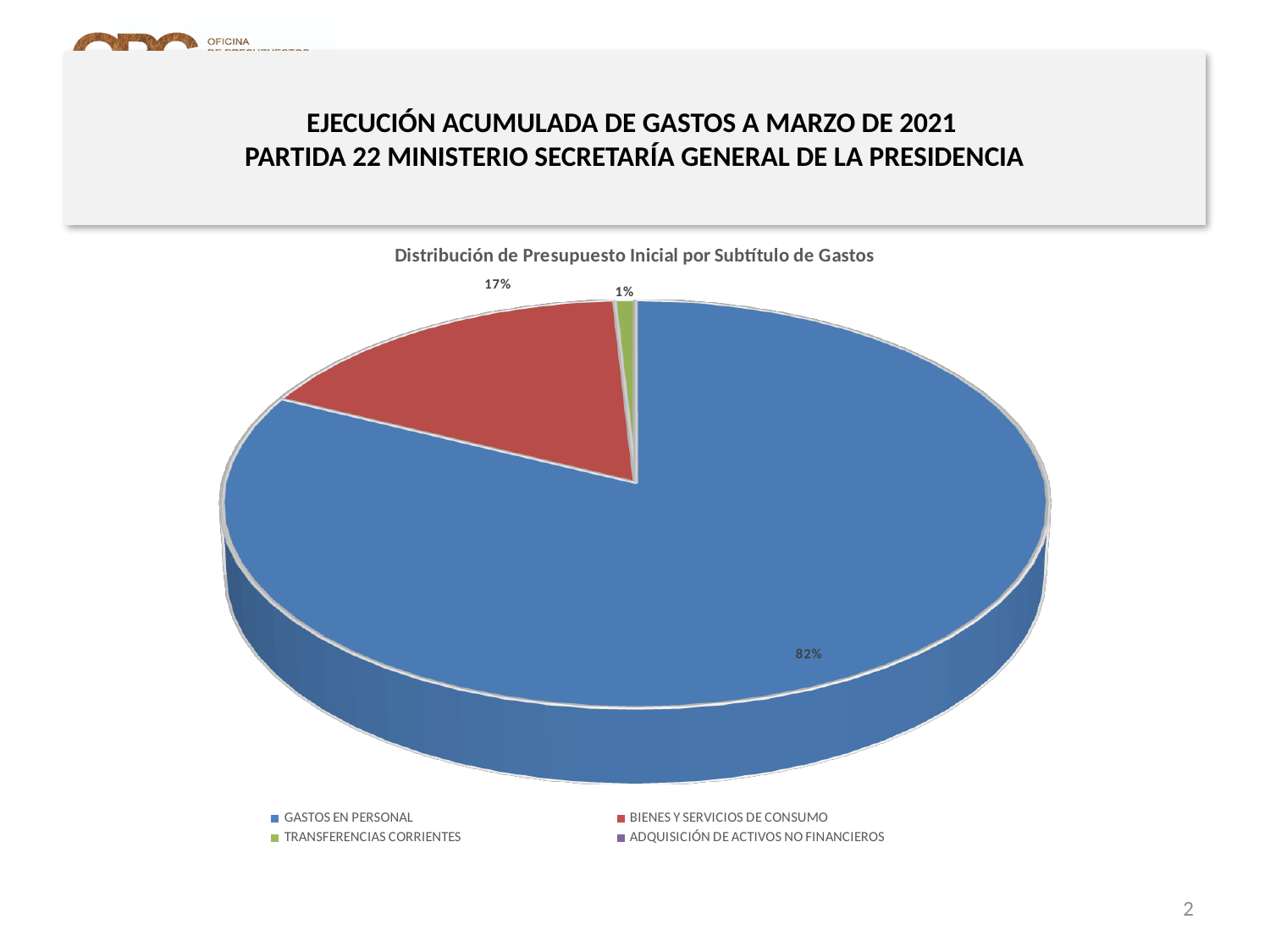
Which category is shown in red in the pie chart? BIENES Y SERVICIOS DE CONSUMO What is the difference in percentage points between the GASTOS EN PERSONAL slice and the BIENES Y SERVICIOS DE CONSUMO slice? 65 percentage points What is the combined share of the GASTOS EN PERSONAL and BIENES Y SERVICIOS DE CONSUMO slices? 99% Which category has the largest slice of the pie? GASTOS EN PERSONAL What share of the pie does GASTOS EN PERSONAL represent? 82% What share of the pie does BIENES Y SERVICIOS DE CONSUMO represent? 17% Which is larger, the BIENES Y SERVICIOS DE CONSUMO slice or the TRANSFERENCIAS CORRIENTES slice? BIENES Y SERVICIOS DE CONSUMO What is the title of the chart? Distribución de Presupuesto Inicial por Subtítulo de Gastos Is the share for GASTOS EN PERSONAL greater or less than 50%? greater How many entries does the legend list? 4 What share of the pie does TRANSFERENCIAS CORRIENTES represent? 1% What type of chart is shown on the slide? Pie chart